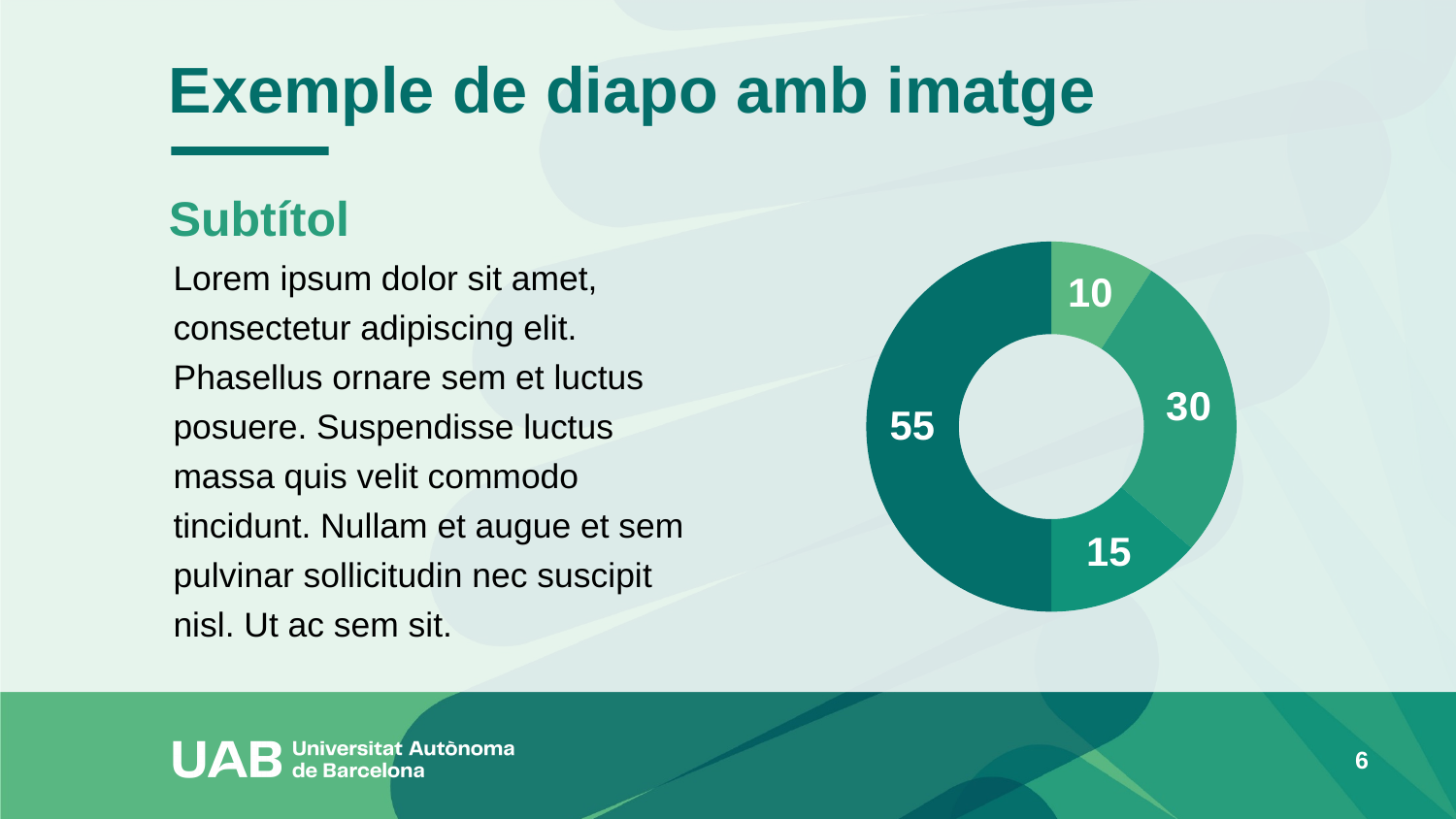
What is the difference between the slices labelled 30 and 15 in the donut chart? 15 What kind of chart is shown on the slide? Donut chart What is the value of the largest slice in the donut chart? 55 What is the total of all the slice values in the donut chart? 110 Which is larger in the donut chart: the slice labelled 30 or the slice labelled 15? 30 What is the value of the slice at the bottom right of the donut chart? 15 What is the difference between the largest slice (55) and the smallest slice (10) in the donut chart? 45 What share of the donut chart does the slice labelled 55 represent? 50% What is the value of the smallest slice in the donut chart? 10 What is the value of the slice on the right side of the donut chart? 30 What colour is the largest slice (55) of the donut chart? Dark green How many slices does the donut chart have? 4